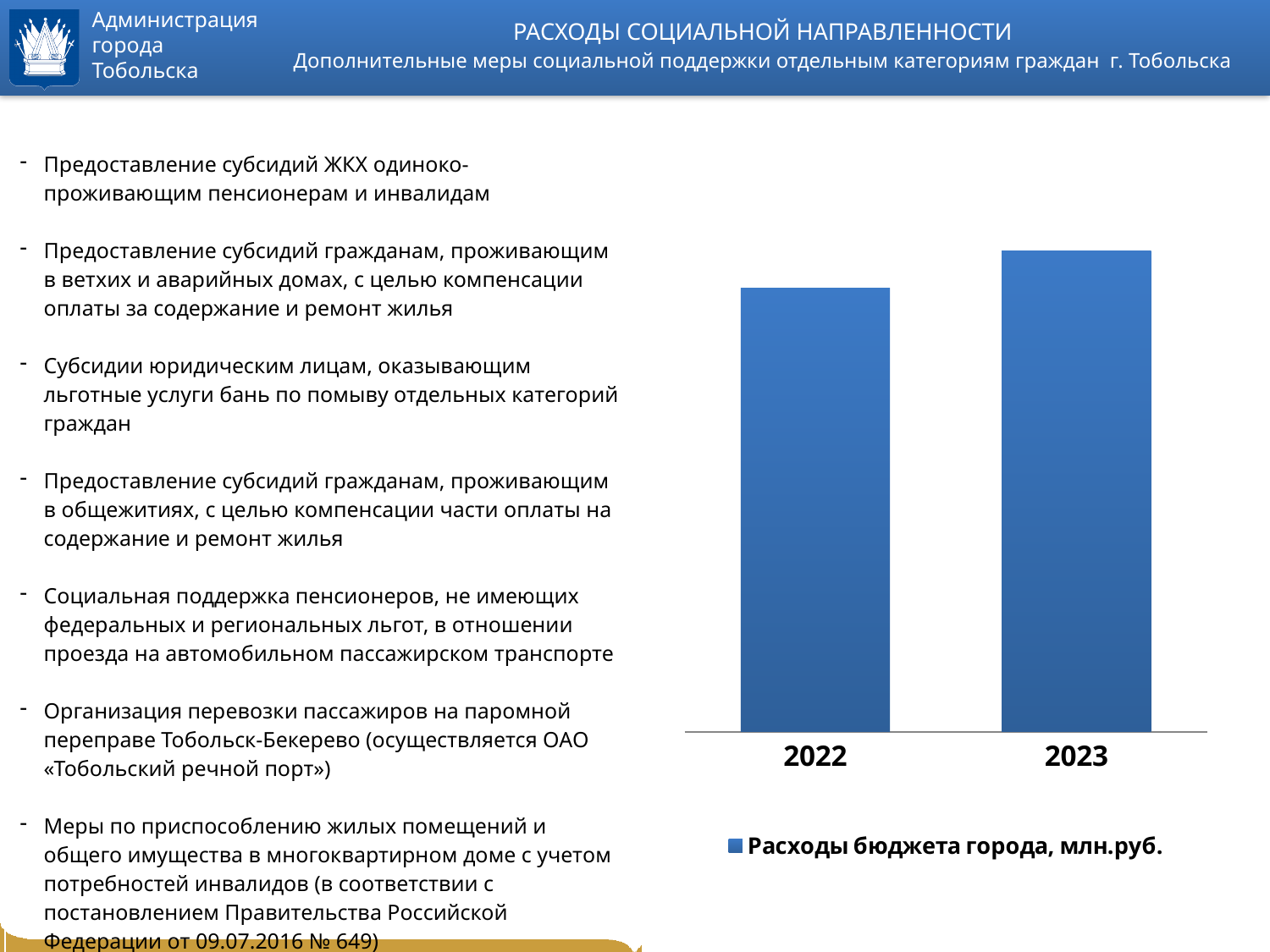
Do the values in the chart rise or fall from 2022 to 2023? rise How many categories are plotted on the x axis of the chart? 2 Which is larger in the chart, the value for 2022 or the value for 2023? 2023 What kind of chart is shown on the slide? bar chart What is the series name shown in the chart legend? Расходы бюджета города, млн.руб. How many series does the chart legend list? 1 Which year has the highest value in the chart? 2023 Which year has the lowest value in the chart? 2022 What unit is stated in the chart legend for the plotted values? млн.руб.